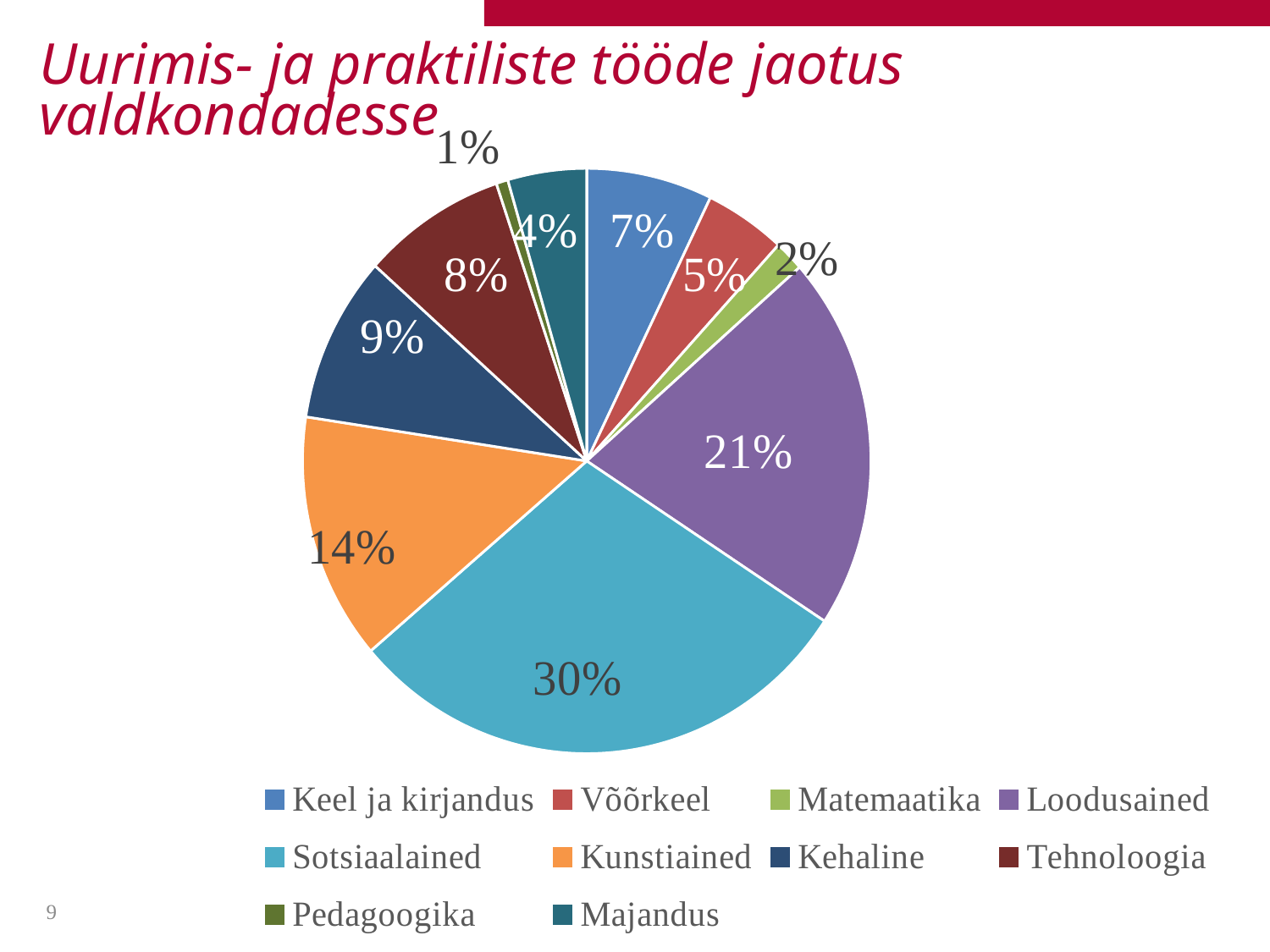
What is the difference in percentage points between Sotsiaalained and Loodusained? 9 How many categories does the legend list? 10 What share of the pie does Sotsiaalained have? 30% What share of the pie does Majandus have? 4% What kind of chart is shown on the slide? pie chart What is the title of the chart slide? Uurimis- ja praktiliste tööde jaotus valdkondadesse Which category has the largest slice of the pie? Sotsiaalained What share of the pie does Keel ja kirjandus have? 7% What share of the pie does Loodusained have? 21% What share of the pie does Kunstiained have? 14% Which has a larger share, Kehaline or Tehnoloogia? Kehaline Which category has the smallest slice of the pie? Pedagoogika